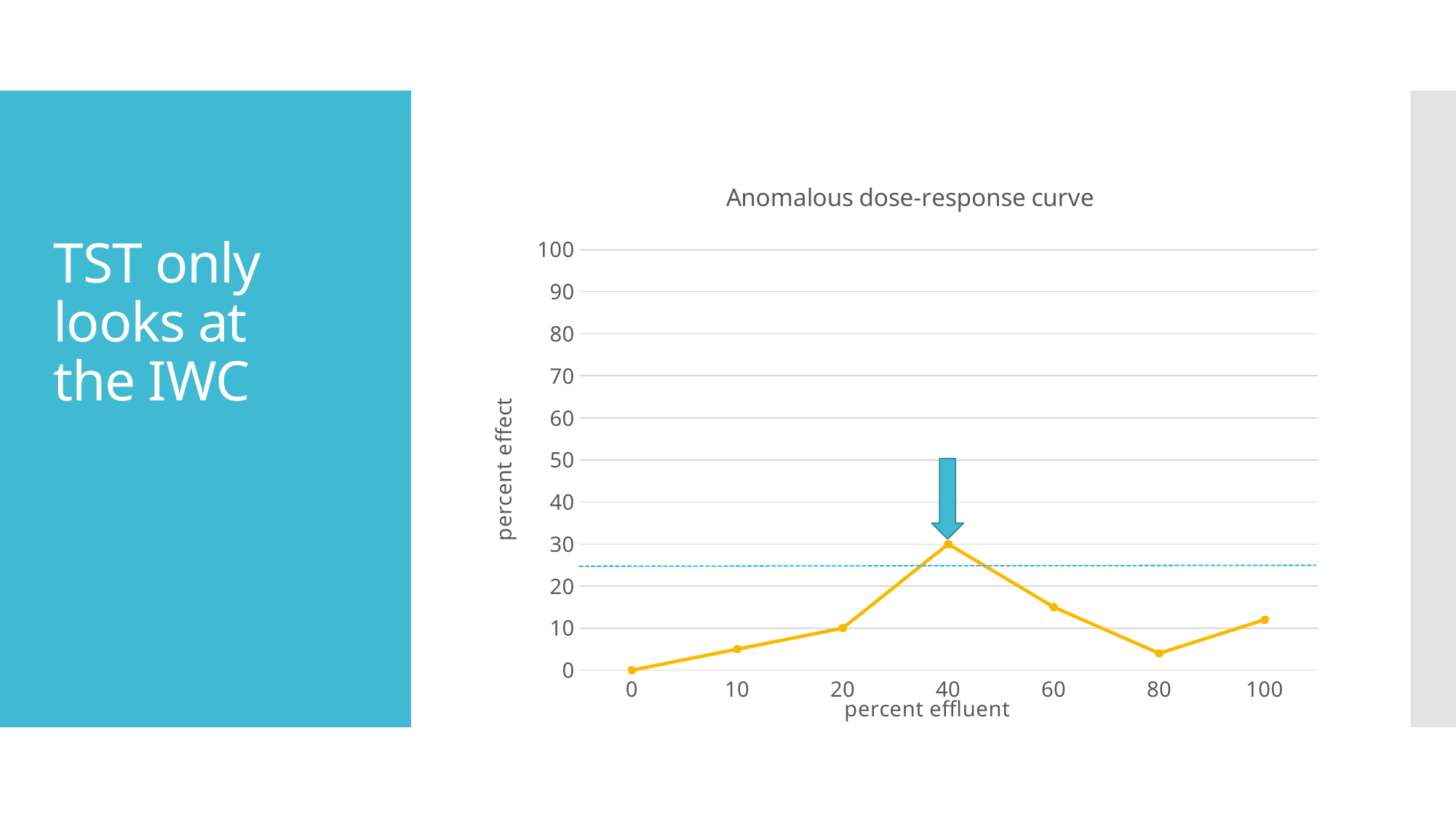
At which percent effluent is the percent effect highest? 40 At which percent effluent is the percent effect lowest? 0 What is the percent effect at 20 percent effluent? 10 What is the label of the x axis? percent effluent What is the percent effect at 40 percent effluent? 30 What is the percent effect at 0 percent effluent? 0 Is the percent effect at 60 percent effluent greater or less than 20? less What is the difference between the percent effect at 40 and at 20 percent effluent? 20 How many data points are plotted on the line? 7 Is the percent effect at 80 percent effluent greater or less than 10? less What is the title of the chart? Anomalous dose-response curve What kind of chart is shown on the slide? line chart